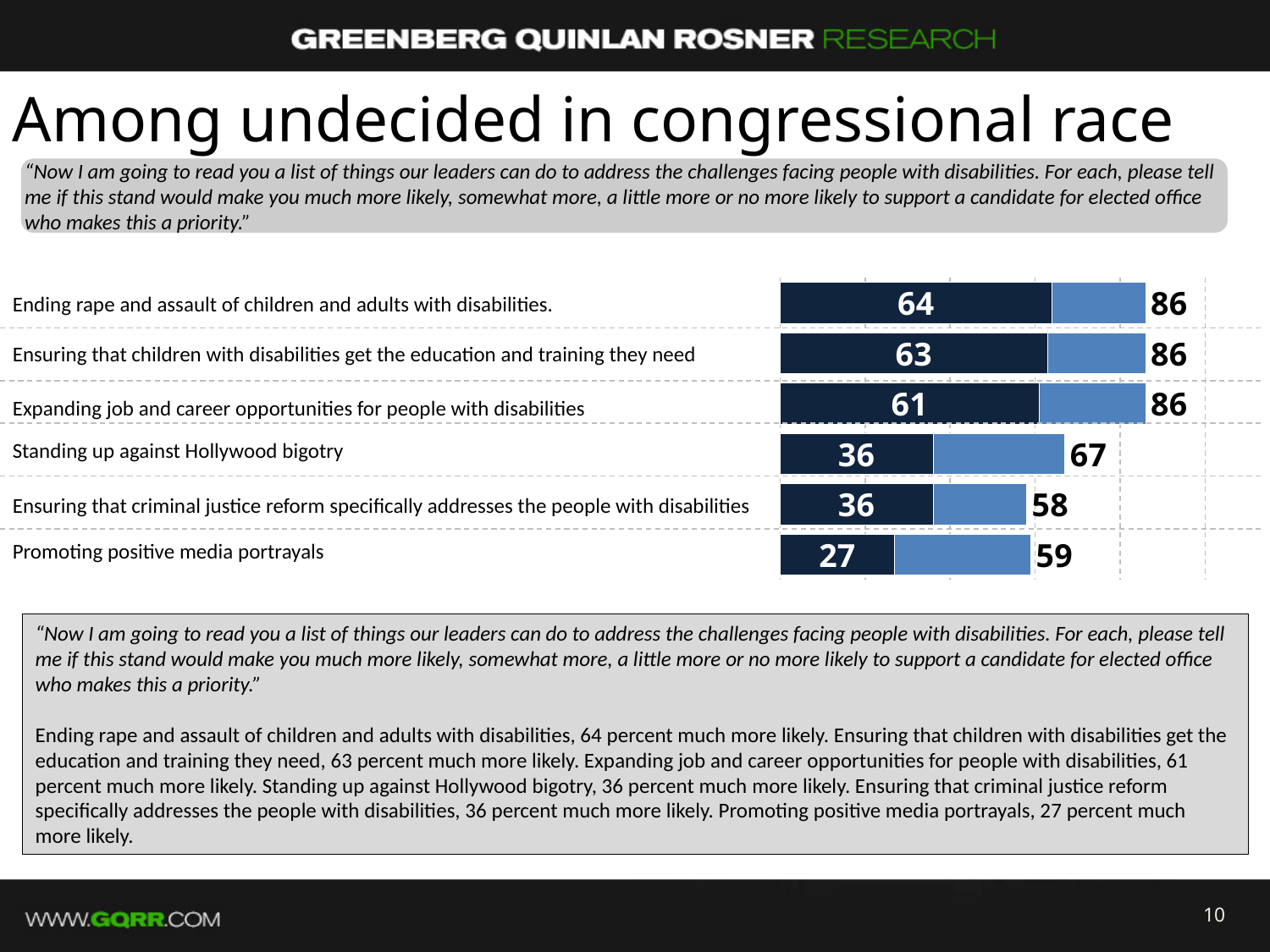
What is the total value shown at the end of the bar for "Ensuring that criminal justice reform specifically addresses the people with disabilities"? 58 What is the dark-blue segment value for "Promoting positive media portrayals"? 27 How many categories are plotted in the chart? 6 Which category has the lowest dark-blue segment value? Promoting positive media portrayals What is the dark-blue segment value for "Ending rape and assault of children and adults with disabilities"? 64 What is the difference between the dark-blue segment values for "Ensuring that children with disabilities get the education and training they need" and "Standing up against Hollywood bigotry"? 27 What kind of chart is shown on the slide? Stacked bar chart What is the difference between the total values for "Expanding job and career opportunities for people with disabilities" and "Promoting positive media portrayals"? 27 Which has a larger dark-blue segment value: "Expanding job and career opportunities for people with disabilities" or "Standing up against Hollywood bigotry"? Expanding job and career opportunities for people with disabilities What is the total value shown at the end of the bar for "Standing up against Hollywood bigotry"? 67 Which category has the lowest total value at the end of its bar? Ensuring that criminal justice reform specifically addresses the people with disabilities Which category has the highest dark-blue segment value? Ending rape and assault of children and adults with disabilities.